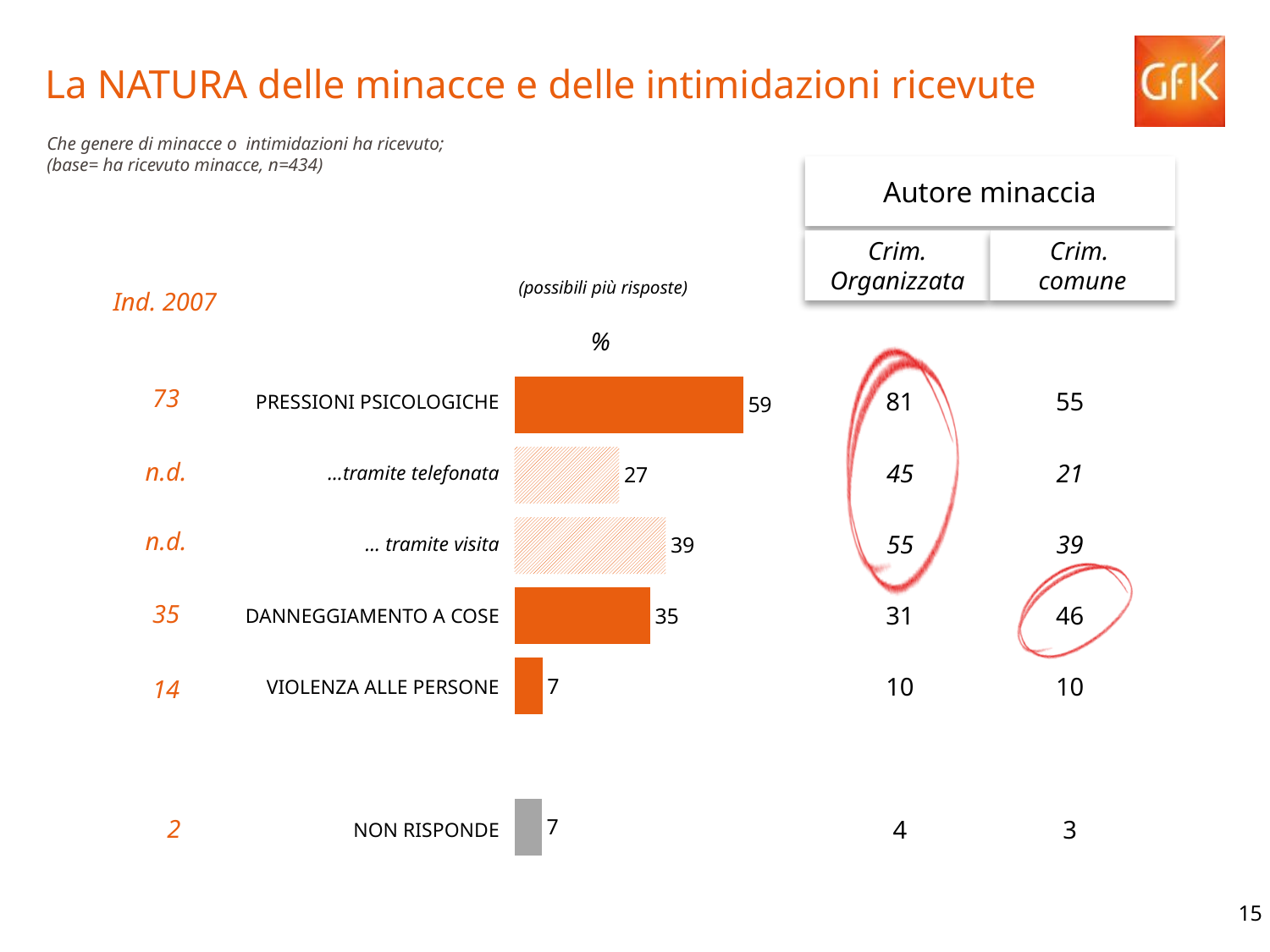
What kind of chart is shown on the slide? bar chart What is the value for DANNEGGIAMENTO A COSE in the bar chart? 35 What is the value for "...tramite telefonata" in the bar chart? 27 What is the Crim. comune value shown for DANNEGGIAMENTO A COSE? 46 What is the Ind. 2007 value shown for PRESSIONI PSICOLOGICHE? 73 Which is larger in the bar chart: DANNEGGIAMENTO A COSE or "... tramite visita"? ... tramite visita What is the value for "... tramite visita" in the bar chart? 39 What is the difference between the values for PRESSIONI PSICOLOGICHE and DANNEGGIAMENTO A COSE? 24 Which category has the highest value in the bar chart? PRESSIONI PSICOLOGICHE What is the difference between the values for "... tramite visita" and "...tramite telefonata"? 12 How many categories are shown in the bar chart? 6 What is the value for PRESSIONI PSICOLOGICHE in the bar chart? 59